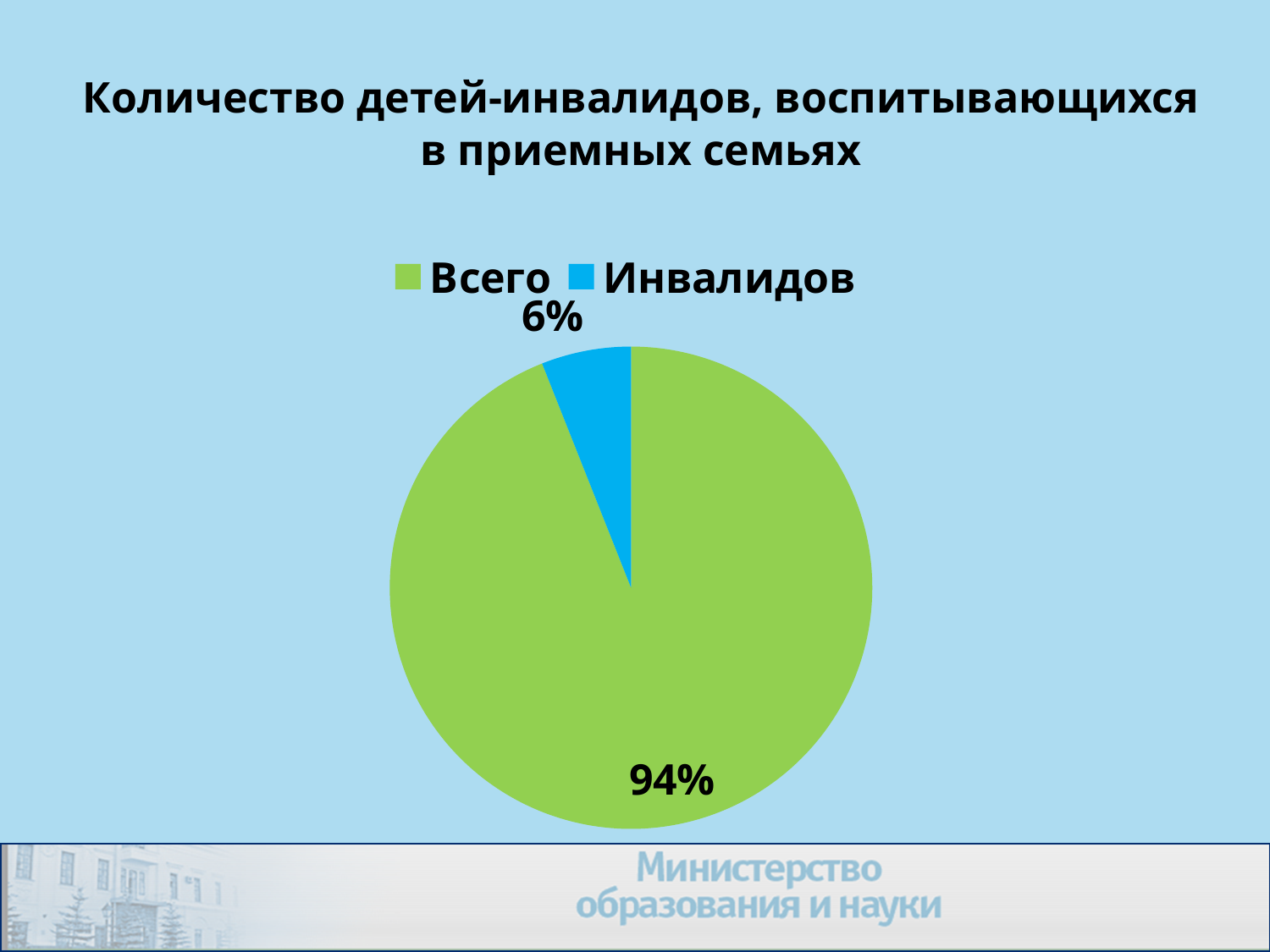
How many entries does the legend list? 2 What is the title of the chart on the slide? Количество детей-инвалидов, воспитывающихся в приемных семьях Which is larger, the "Всего" slice or the "Инвалидов" slice? Всего What share of the pie does the "Всего" slice represent? 94% What is the difference in percentage points between the "Всего" slice and the "Инвалидов" slice? 88 What share of the pie does the "Инвалидов" slice represent? 6% Which slice is the largest in the pie chart? Всего What colour is the "Инвалидов" slice in the pie chart? blue How many slices does the pie chart have? 2 Which slice is the smallest in the pie chart? Инвалидов What kind of chart is shown on the slide? pie chart